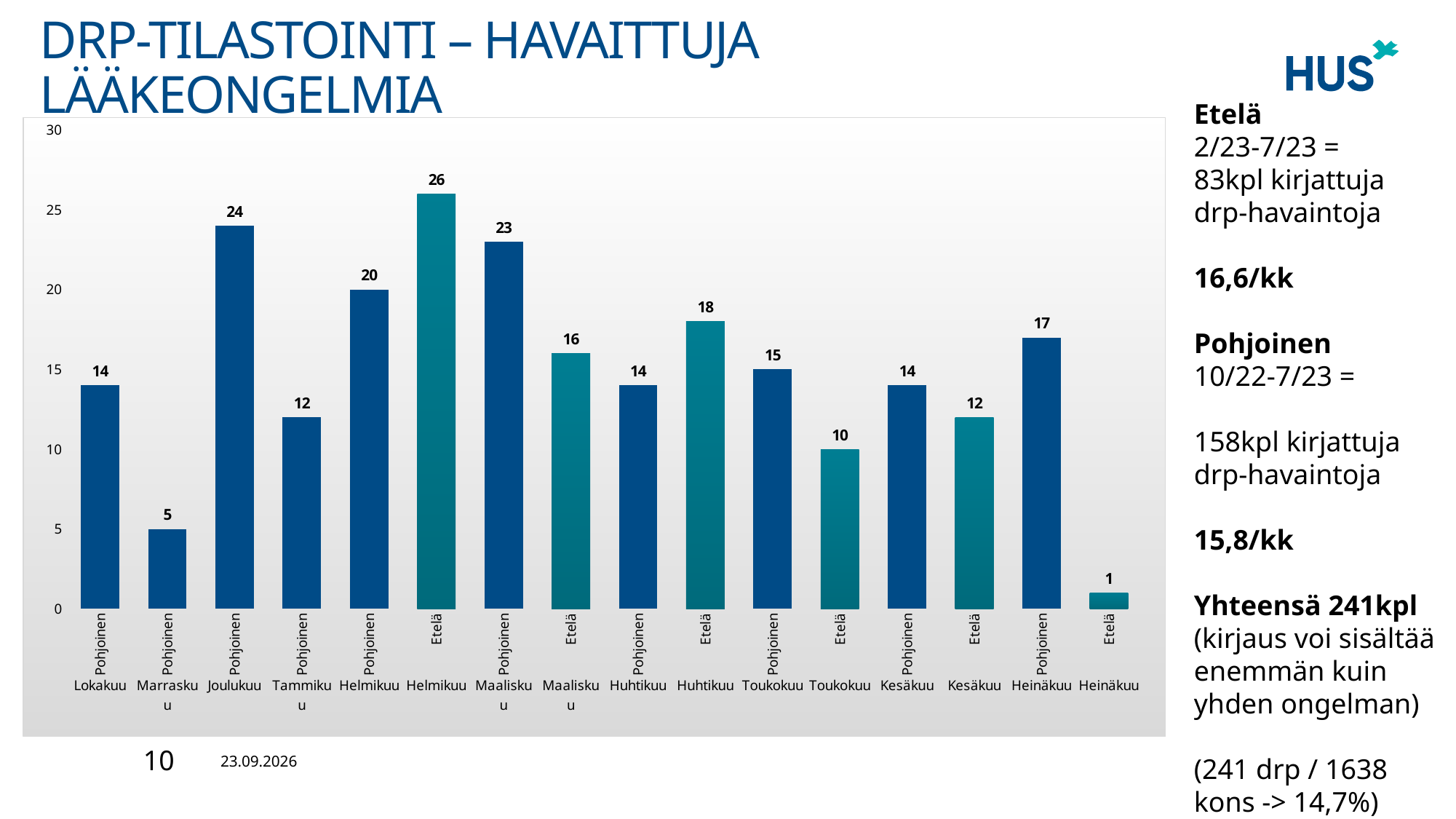
What is the difference between the Pohjoinen value in Maaliskuu and the Etelä value in Maaliskuu? 7 Which bar has the lowest value in the chart? Heinäkuu Etelä Which bar has the highest value in the chart? Helmikuu Etelä What is the value for Pohjoinen in Marraskuu? 5 How many bars are plotted in the chart? 16 What is the value for Pohjoinen in Joulukuu? 24 What is the title of the slide containing the chart? DRP-TILASTOINTI – HAVAITTUJA LÄÄKEONGELMIA What is the value for Etelä in Helmikuu? 26 What kind of chart is shown on the slide? bar chart Which is larger in Huhtikuu: the Pohjoinen value or the Etelä value? Etelä What is the value for Etelä in Heinäkuu? 1 What is the difference between the Pohjoinen values in Joulukuu and Tammikuu? 12